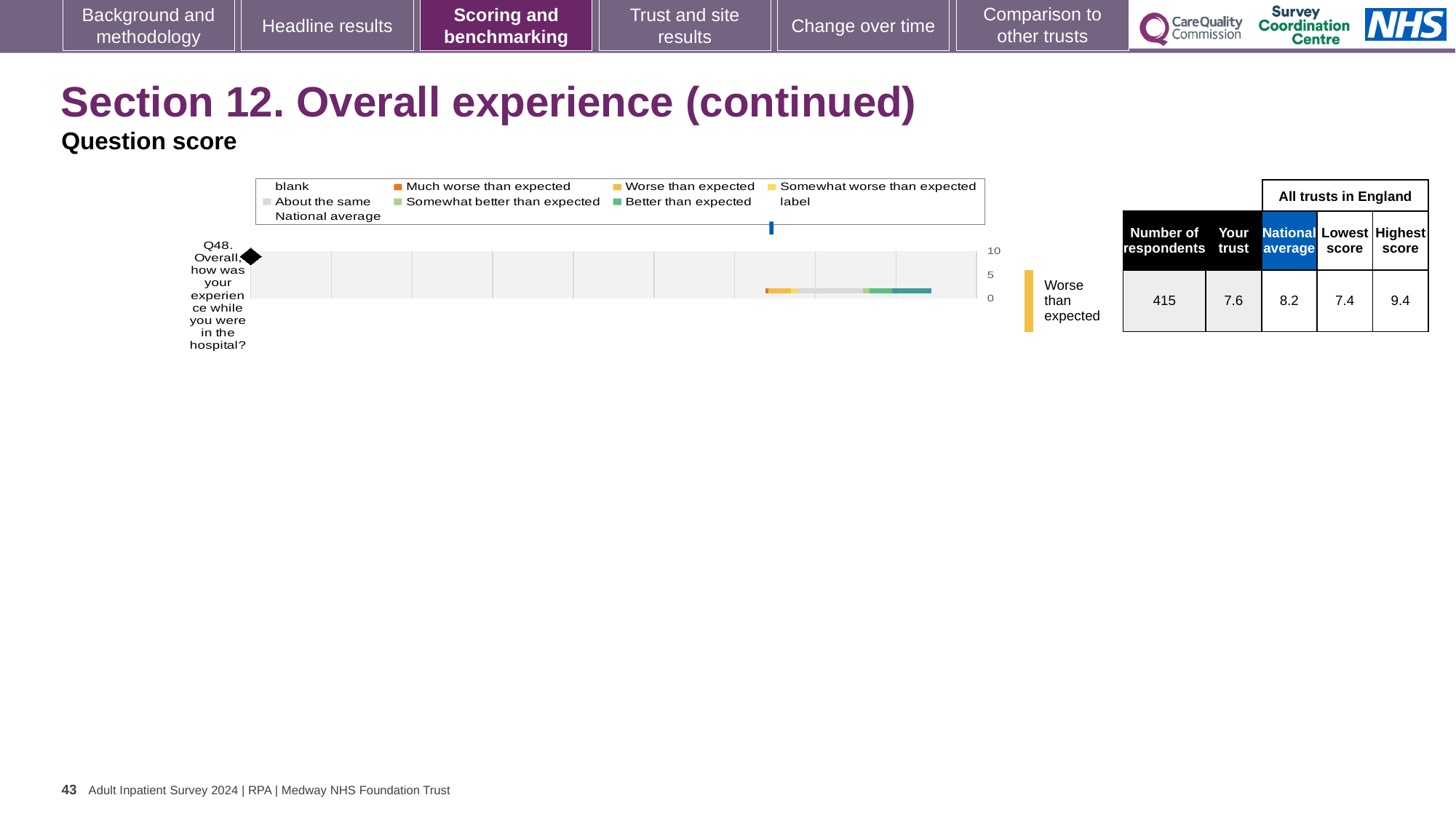
For Q48, which is larger: the 'Your trust' score or the national average? National average For Q48, what is the difference between the highest score and the lowest score among all trusts in England? 2.0 Which question is plotted in the chart? Q48. Overall, how was your experience while you were in the hospital? What benchmark label is shown beside the chart for Q48? Worse than expected How many respondents answered Q48 according to the table next to the chart? 415 In the table next to the chart, what is the highest score among all trusts in England for Q48? 9.4 For Q48, how much higher is the national average than the 'Your trust' score? 0.6 In the table next to the chart, what is the national average score for Q48? 8.2 How many survey questions are plotted in the chart? 1 In the table next to the chart, what is the 'Your trust' score for Q48? 7.6 What kind of chart is shown for Q48 on the slide? bar chart In the table next to the chart, what is the lowest score among all trusts in England for Q48? 7.4